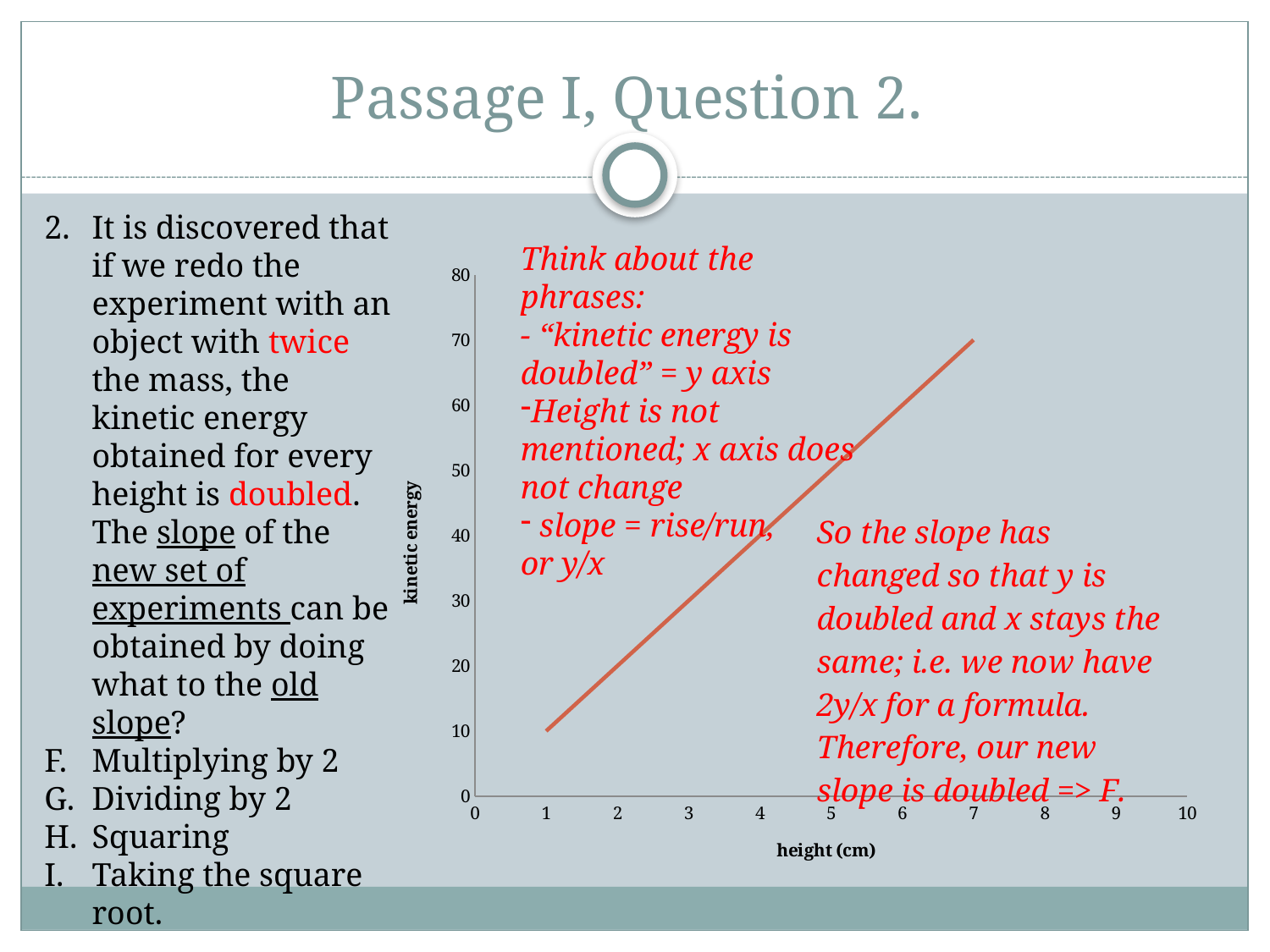
What is the kinetic energy at a height of 1 cm, where the line starts? 10 Is the kinetic energy at a height of 2 cm greater or less than 30? less What is the label of the y axis of the chart? kinetic energy What is the highest value shown on the y axis of the chart? 80 Is the kinetic energy at a height of 6 cm greater or less than 50? greater Is the kinetic energy at a height of 4 cm greater or less than 30? greater What is the difference between the kinetic energy at the end of the line (height 7 cm) and at the start of the line (height 1 cm)? 60 Which is larger, the kinetic energy at a height of 3 cm or at a height of 5 cm? 5 cm What is the kinetic energy at a height of 7 cm, where the line ends? 70 What is the label of the x axis of the chart? height (cm) What kind of chart is shown on the slide? line chart Does kinetic energy rise or fall as height increases along the x axis? rise